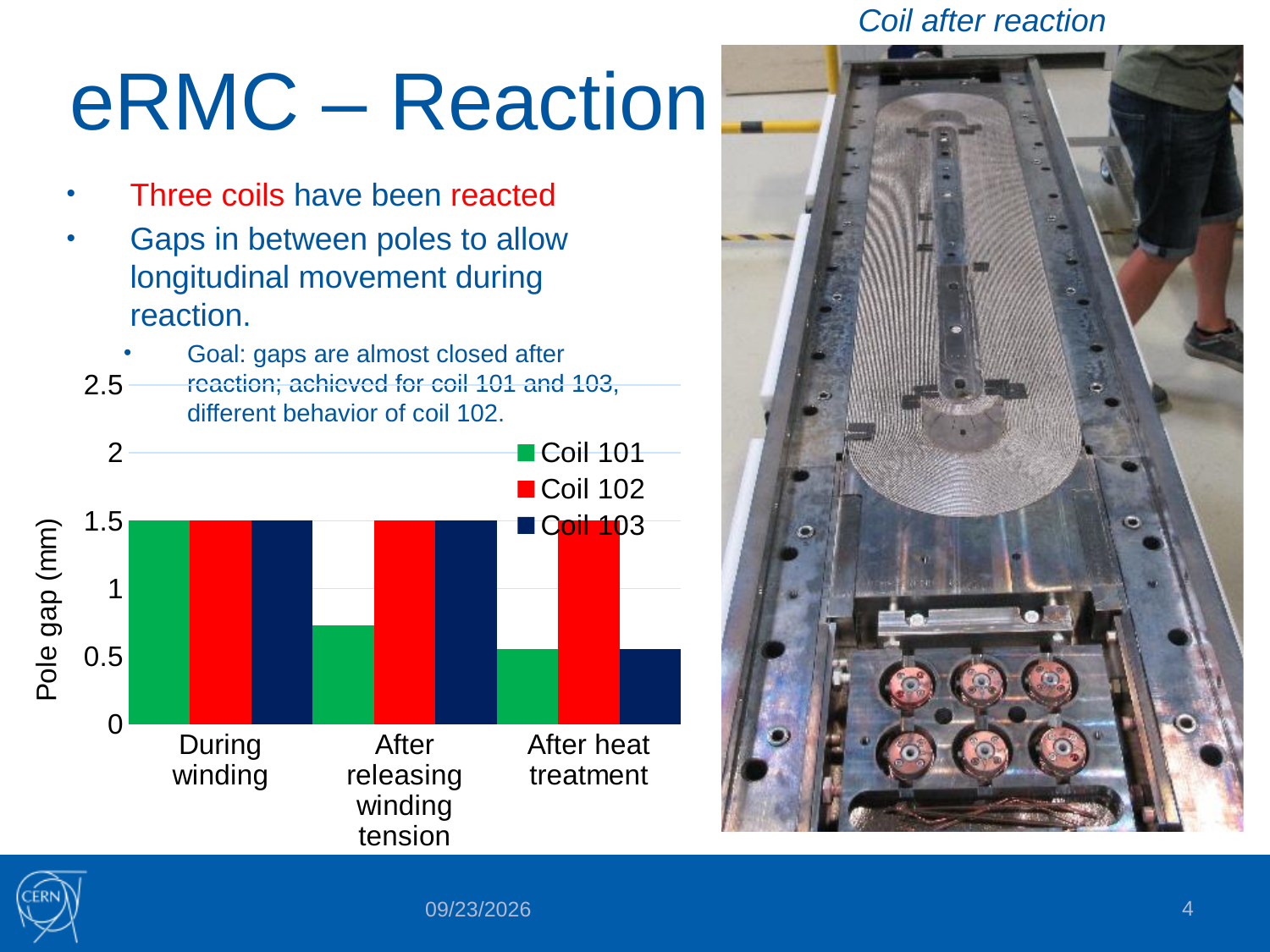
What is the pole gap for Coil 101 during winding? 1.5 What is the pole gap for Coil 103 after releasing winding tension? 1.5 Which coil has the lowest pole gap after releasing winding tension? Coil 101 What is the label of the y axis of the chart? Pole gap (mm) Is the pole gap for Coil 103 after heat treatment greater or less than 1? less What kind of chart is shown on the slide? bar chart Is the pole gap for Coil 101 after releasing winding tension greater or less than 1? less How many series does the chart legend list? 3 Does the pole gap for Coil 101 rise or fall from 'During winding' to 'After heat treatment'? fall What is the pole gap for Coil 102 after heat treatment? 1.5 Which coil has the highest pole gap after heat treatment? Coil 102 How many categories are shown on the x axis of the chart? 3